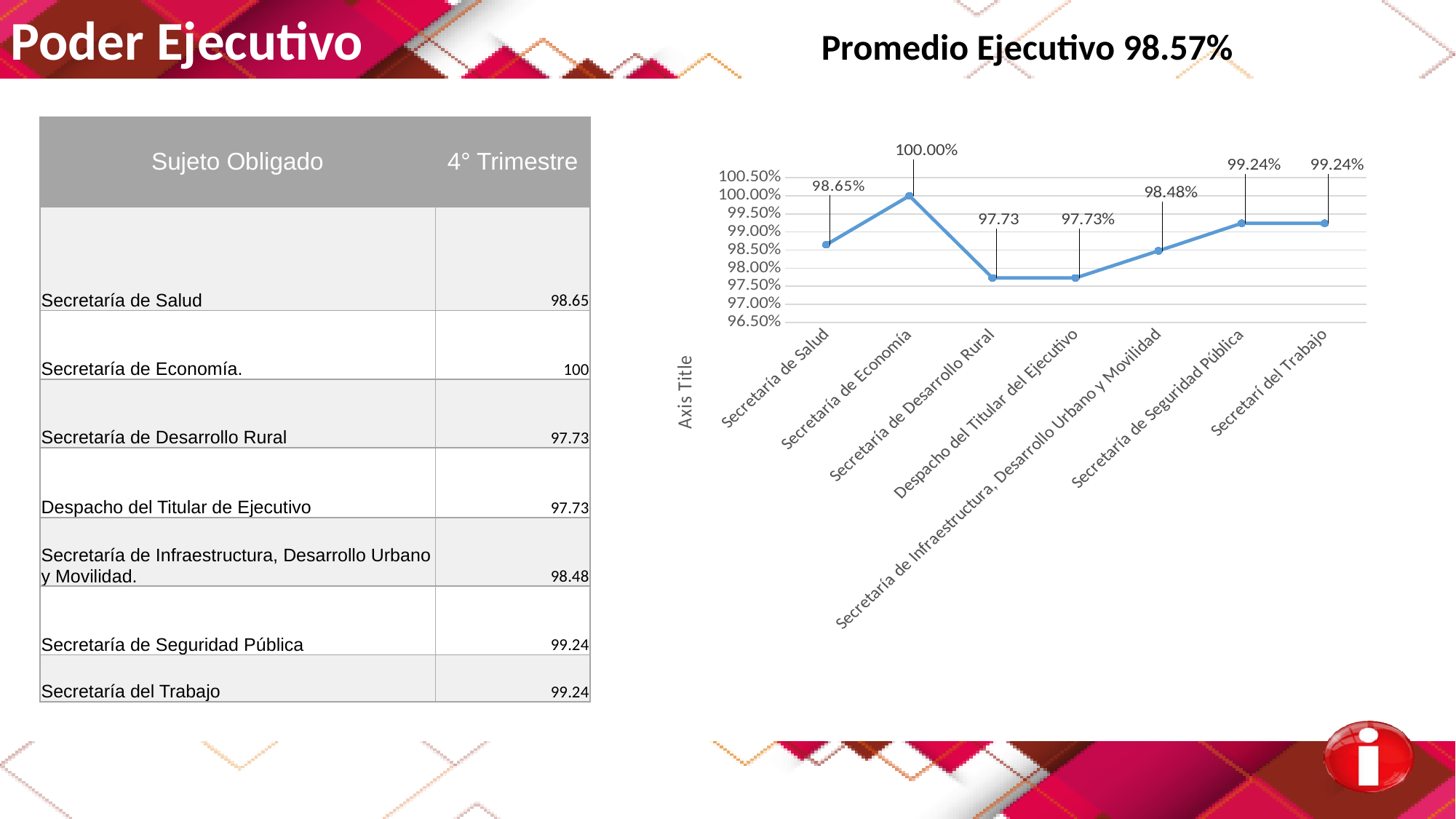
What is the title shown on the vertical axis of the chart? Axis Title How many categories are plotted along the x axis of the chart? 7 Is the value for Secretaría de Desarrollo Rural greater or less than 98.00%? less What is the value plotted for Secretaría de Salud? 98.65% What is the value plotted for Secretaría de Economía? 100.00% Which category has the highest value in the chart? Secretaría de Economía Which is larger, the value for Secretaría de Salud or the value for Secretaría de Desarrollo Rural? Secretaría de Salud Does the line rise or fall from Secretaría de Economía to Secretaría de Desarrollo Rural? fall What is the value plotted for Secretaría de Infraestructura, Desarrollo Urbano y Movilidad? 98.48% What type of chart is shown on the slide? line chart What is the difference between the value for Secretaría de Economía and the value for Secretaría de Salud? 1.35% What is the value plotted for Secretaría de Seguridad Pública? 99.24%